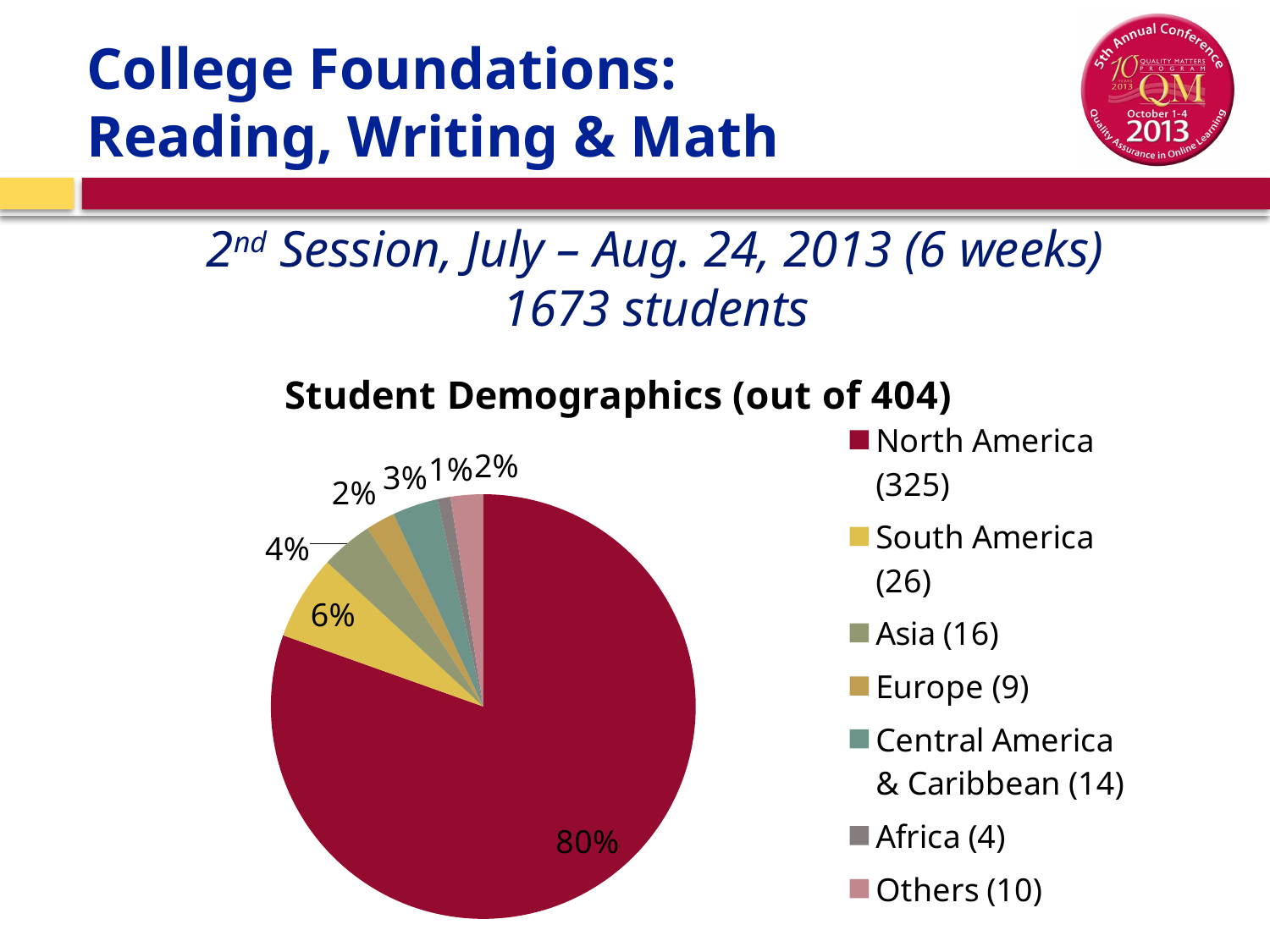
How many more students are from North America than from South America? 299 What share of the pie does South America represent? 6% What kind of chart is shown on the slide? pie chart Which category has the smallest slice of the pie? Africa How many students are from Europe according to the legend? 9 Which has more students, Asia or Europe? Asia What share of the pie does North America represent? 80% How many students are from Asia according to the legend? 16 What is the title of the chart? Student Demographics (out of 404) Which category has the largest slice of the pie? North America What share of the pie does Central America & Caribbean represent? 3% How many categories does the pie chart have? 7